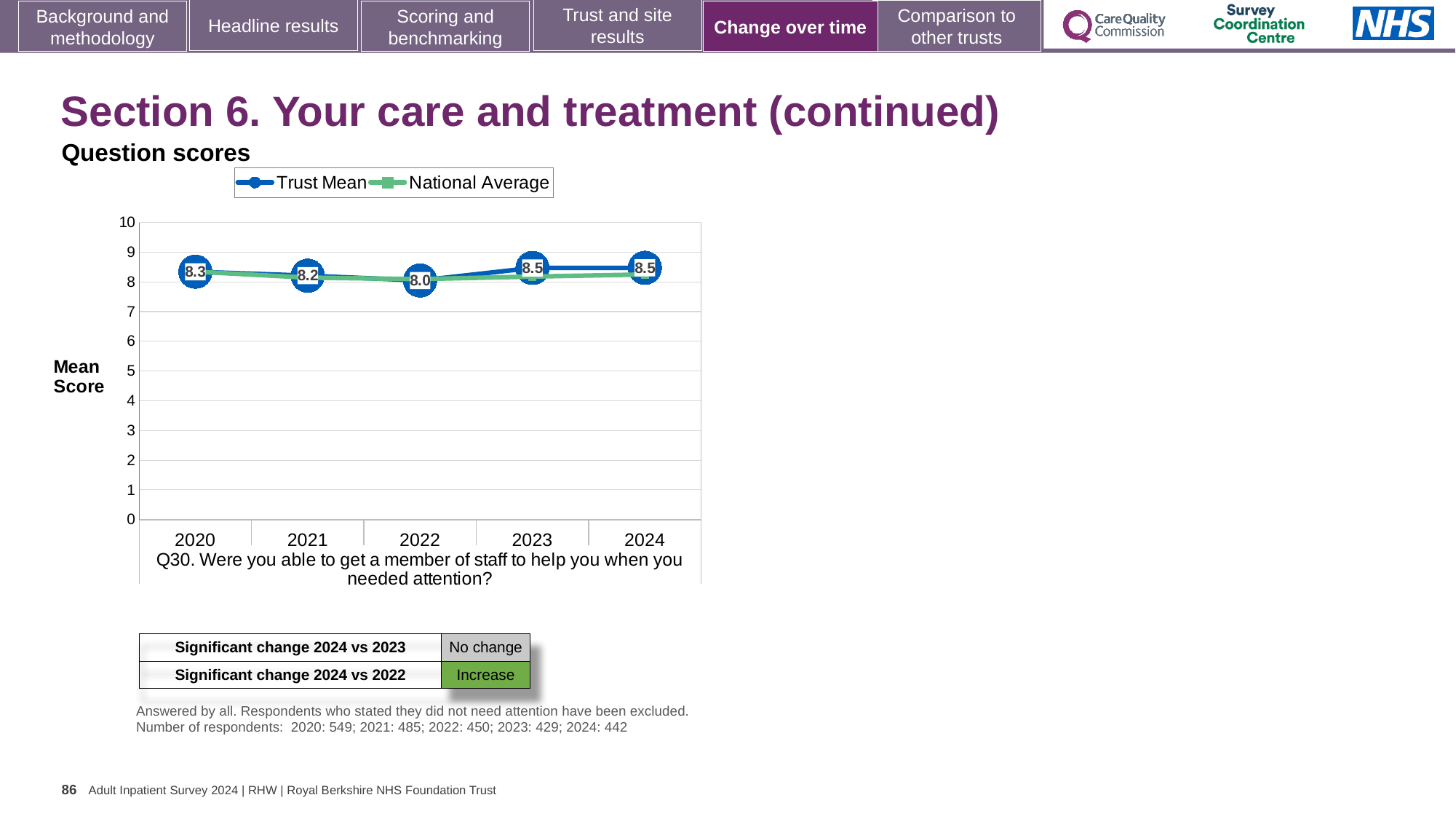
What is the Trust Mean score for 2020? 8.3 How many years are plotted on the x axis? 5 What is the Trust Mean score for 2024? 8.5 What is the difference between the Trust Mean score in 2024 and in 2022? 0.5 What is the Trust Mean score for 2022? 8.0 Which year has the higher Trust Mean score, 2020 or 2021? 2020 Does the Trust Mean score rise or fall from 2022 to 2024? Rise In which year is the Trust Mean score lowest? 2022 What is the label on the y axis of the chart? Mean Score What kind of chart is shown? Line chart Is the National Average value for 2022 greater or less than 7? greater How many series does the legend list? 2